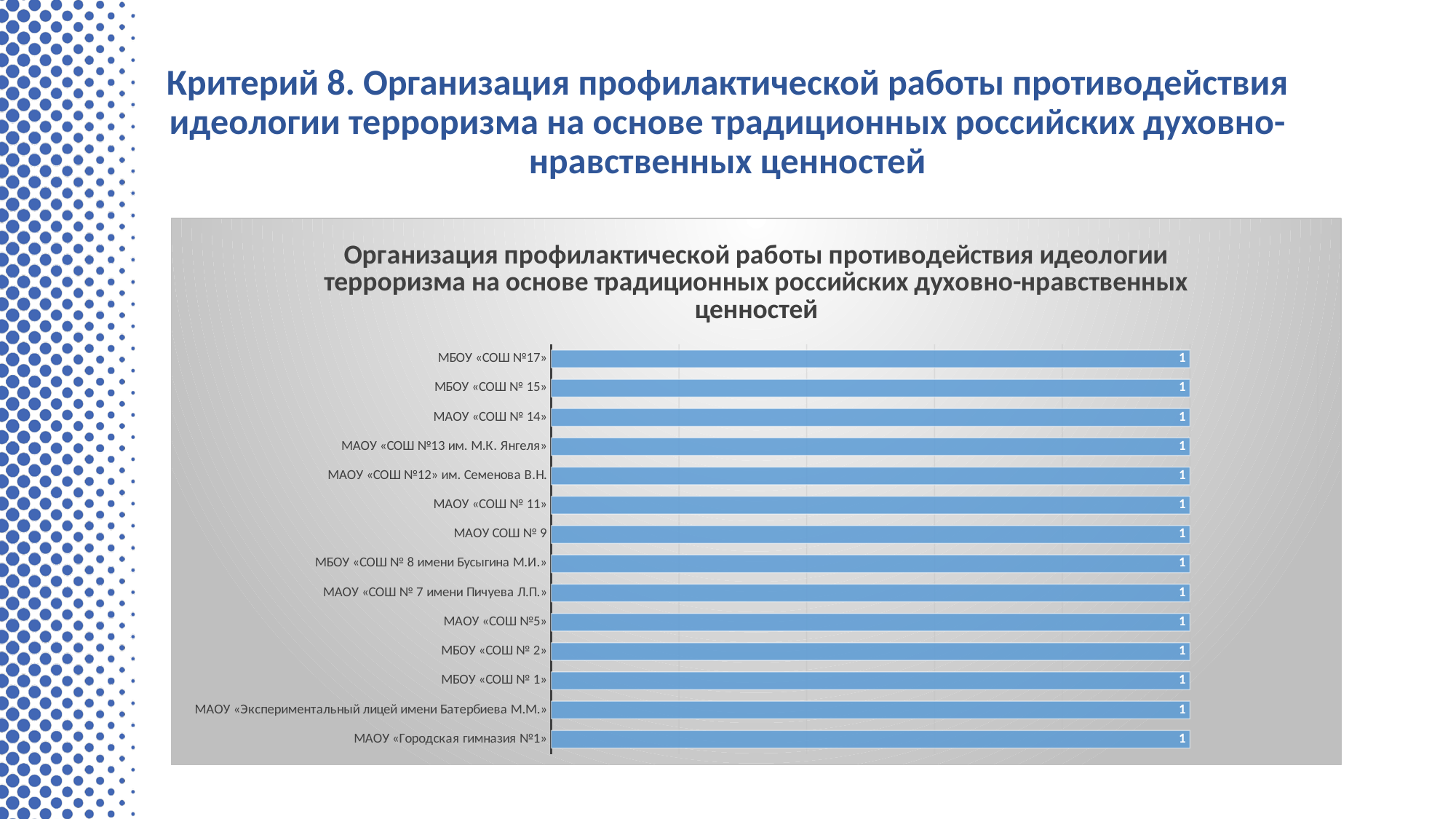
What is the value shown for МАОУ «Городская гимназия №1»? 1 What is the value shown for МБОУ «СОШ №17»? 1 What is the value shown for МБОУ «СОШ № 8 имени Бусыгина М.И.»? 1 How many schools (categories) are plotted in the chart? 14 Do the values change from one school to the next, or do they all stay the same? They all stay the same What is the value shown for МАОУ «СОШ №13 им. М.К. Янгеля»? 1 What is the difference between the values for МБОУ «СОШ № 1» and МАОУ «СОШ №5»? 0 What colour are the bars in the chart? Blue What is the value shown for МАОУ «Экспериментальный лицей имени Батербиева М.М.»? 1 Which school is listed at the top of the chart? МБОУ «СОШ №17» What kind of chart is shown on the slide? bar chart